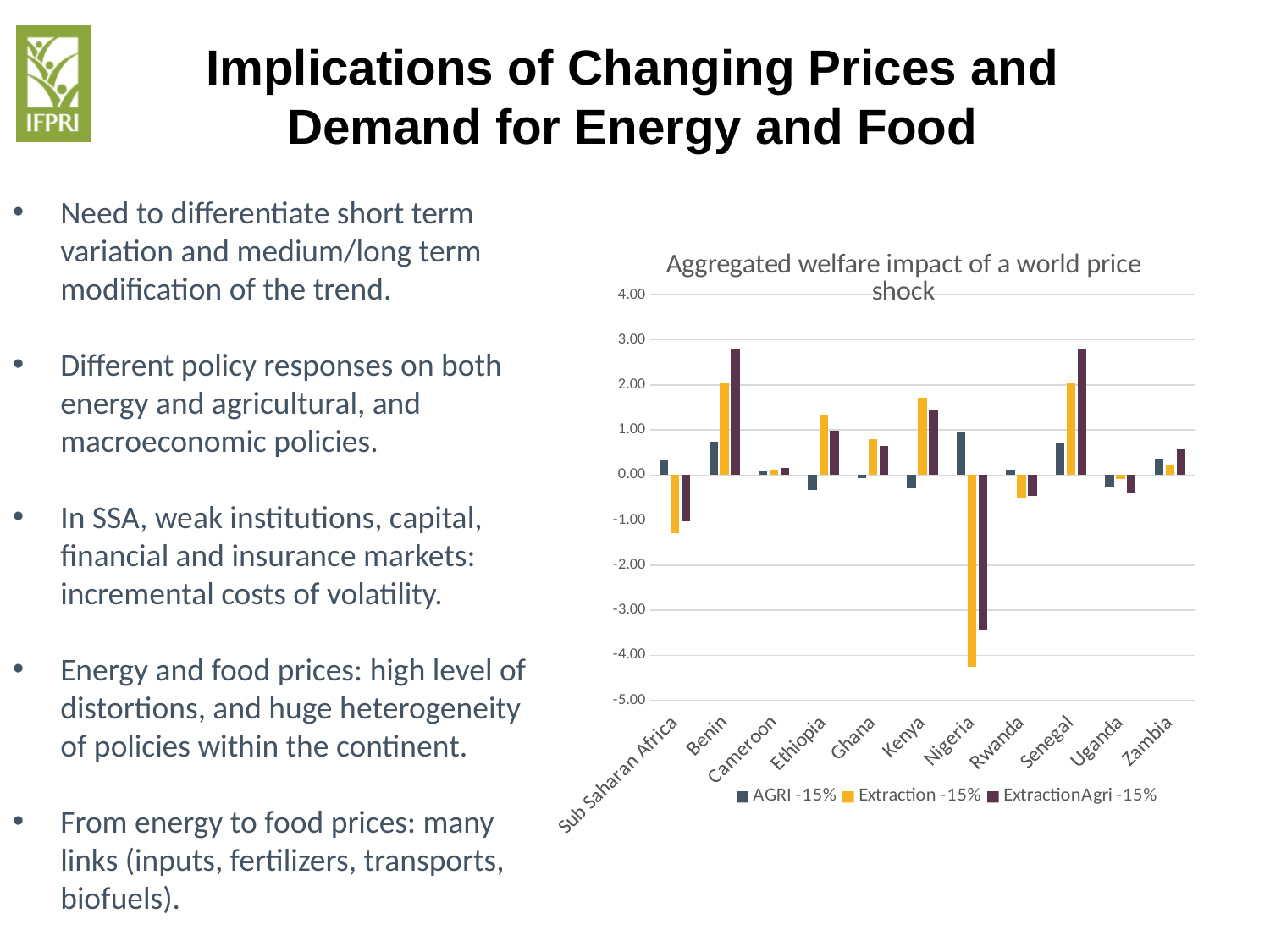
How many countries/regions are shown on the x axis of the chart? 11 How many series does the chart legend list? 3 What kind of chart is shown on the slide? bar chart What is the title of the chart? Aggregated welfare impact of a world price shock For Nigeria, which is larger: the AGRI -15% value or the Extraction -15% value? AGRI -15% Which series are listed in the chart legend? AGRI -15%, Extraction -15%, ExtractionAgri -15% Is the Extraction -15% value for Nigeria greater or less than -4.00? less Which country has the highest value for the AGRI -15% series? Nigeria Is the ExtractionAgri -15% value for Nigeria greater or less than -3.00? less Is the Extraction -15% value for Sub Saharan Africa greater or less than -1.00? less Which country has the lowest value for the Extraction -15% series? Nigeria